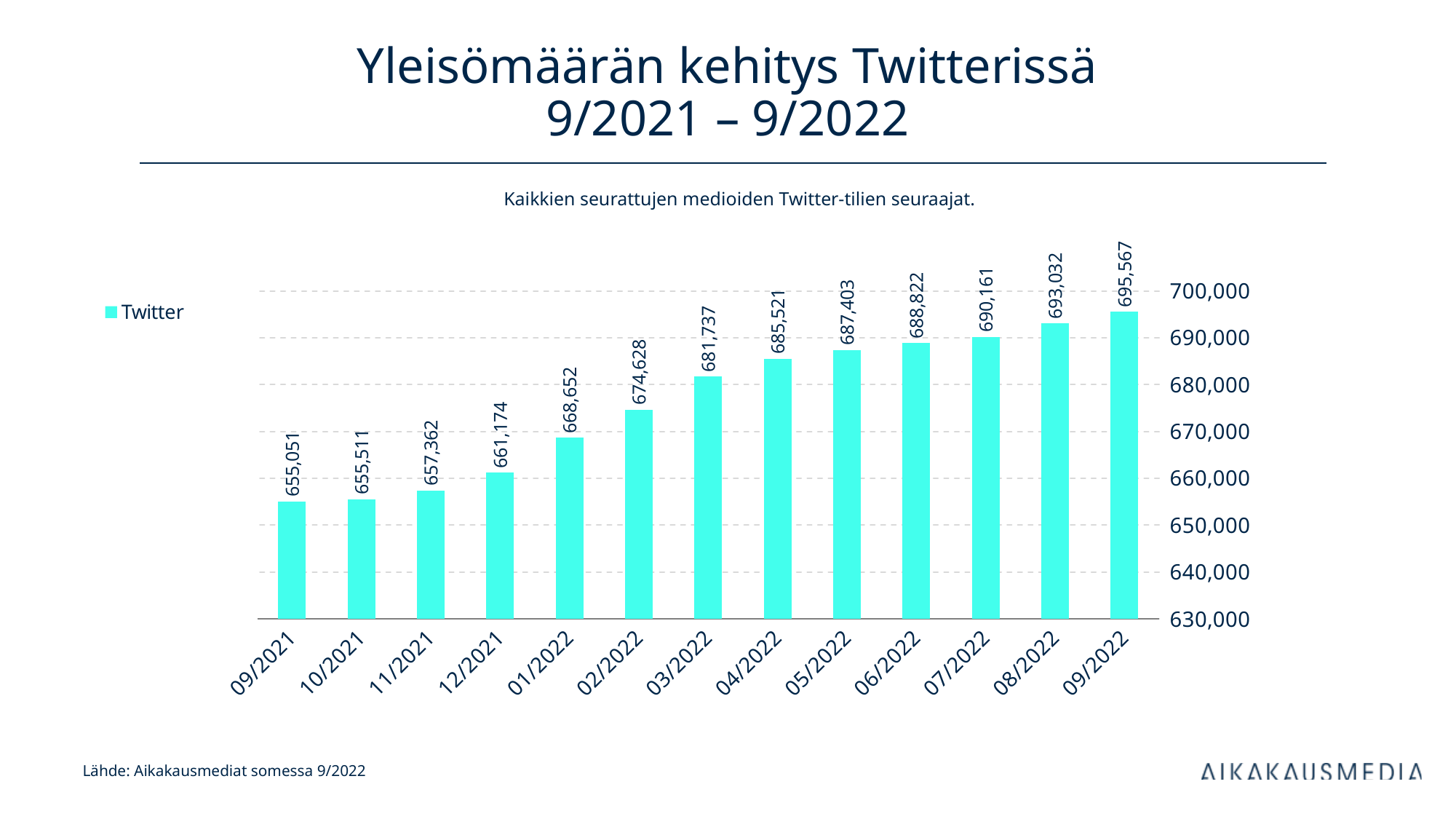
What is the difference between the values for 02/2022 and 01/2022? 5,976 Which is larger, the value for 05/2022 or the value for 11/2021? 05/2022 Do the values rise or fall from 09/2021 to 09/2022? rise How many months are shown on the x axis? 13 What is the value for 09/2021? 655,051 Which month has the highest value? 09/2022 What kind of chart is shown on the slide? bar chart Is the value for 07/2022 greater or less than 680,000? greater Which month has the lowest value? 09/2021 What is the value for 12/2021? 661,174 What is the value for 03/2022? 681,737 What is the difference between the values for 09/2022 and 09/2021? 40,516